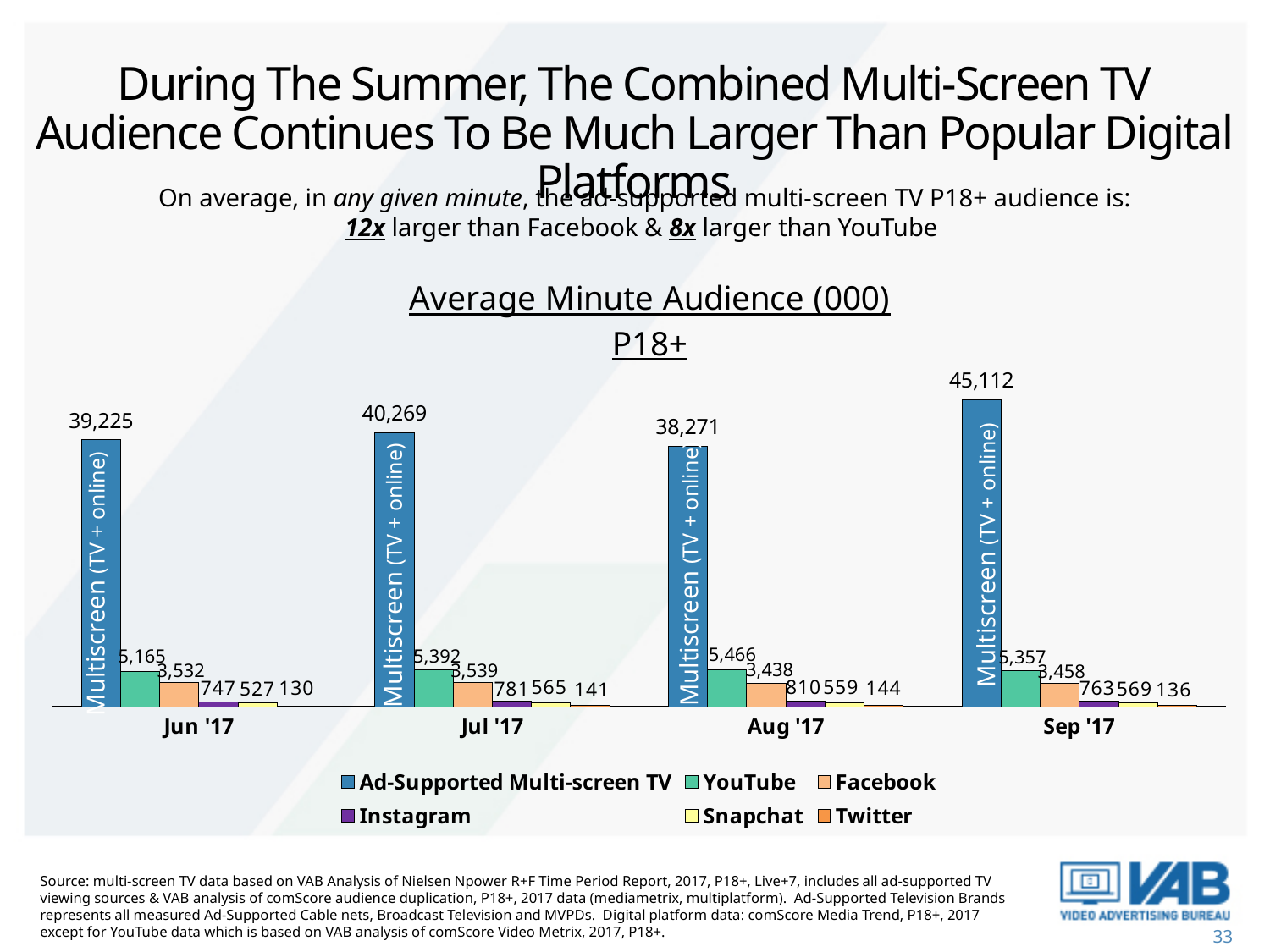
What is the difference between the Instagram values for Aug '17 and Jun '17? 63 What is the value for Twitter in Jul '17? 141 What is the value for Snapchat in Sep '17? 569 What is the difference between the Ad-Supported Multi-screen TV values for Sep '17 and Jun '17? 5,887 How many series does the legend list? 6 In which month is the Ad-Supported Multi-screen TV audience lowest? Aug '17 What is the value for Instagram in Aug '17? 810 In Jun '17, which is larger: Instagram or Snapchat? Instagram What kind of chart is shown on the slide? Bar chart In which month is the Ad-Supported Multi-screen TV audience highest? Sep '17 How many months are shown on the x axis? 4 What is the value for Ad-Supported Multi-screen TV in Sep '17? 45,112